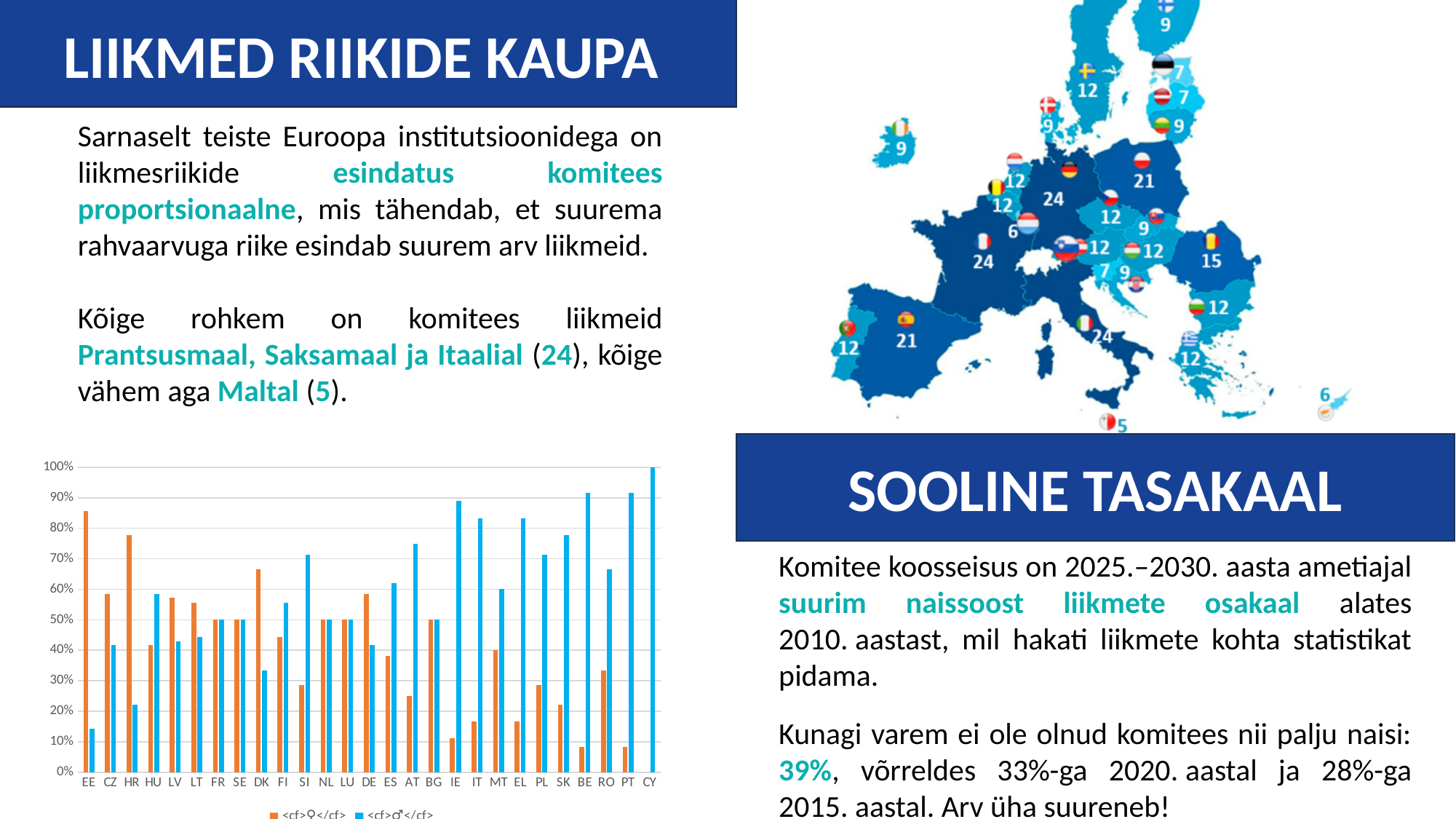
In the bar chart, is the blue bar for IE greater or less than 80%? greater What is the highest value shown on the y axis of the bar chart? 100% How many series does the legend of the bar chart list? 2 In the bar chart, what is the value of the orange bar for FR? 50% In the bar chart, what is the value of the blue bar for CY? 100% In the bar chart, which country has the highest orange bar? EE How many country categories are shown on the x axis of the bar chart? 27 In the bar chart, is the blue bar for EE greater or less than 20%? less In the bar chart, which country has the highest blue bar? CY What kind of chart is shown at the bottom left of the slide? bar chart In the bar chart, which is larger for IT, the orange bar or the blue bar? the blue bar In the bar chart, is the orange bar for EE greater or less than 80%? greater